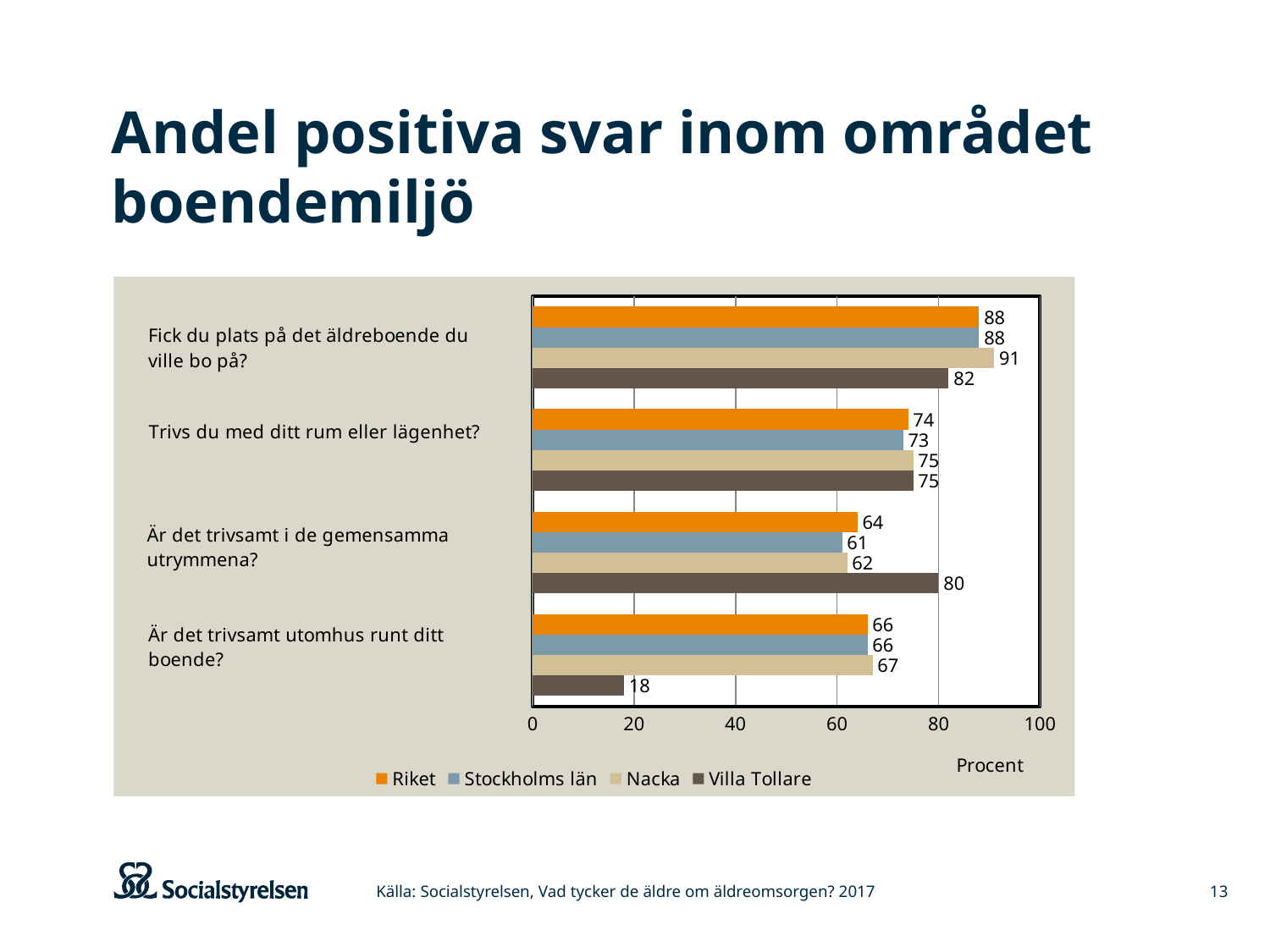
How many series does the legend list? 4 What value is shown for Villa Tollare on "Är det trivsamt utomhus runt ditt boende?"? 18 Is the value for Villa Tollare on "Är det trivsamt utomhus runt ditt boende?" greater or less than 20? less How many questions (categories) are shown on the chart? 4 What value is shown for Nacka on "Fick du plats på det äldreboende du ville bo på?"? 91 What is the label on the horizontal axis? Procent What value is shown for Stockholms län on "Trivs du med ditt rum eller lägenhet?"? 73 Which series has the lowest value on "Är det trivsamt utomhus runt ditt boende?"? Villa Tollare Which is larger on "Fick du plats på det äldreboende du ville bo på?": Nacka or Villa Tollare? Nacka What kind of chart is shown on the slide? bar chart Which series has the highest value on "Är det trivsamt i de gemensamma utrymmena?"? Villa Tollare What is the difference between Villa Tollare and Riket on "Är det trivsamt i de gemensamma utrymmena?"? 16